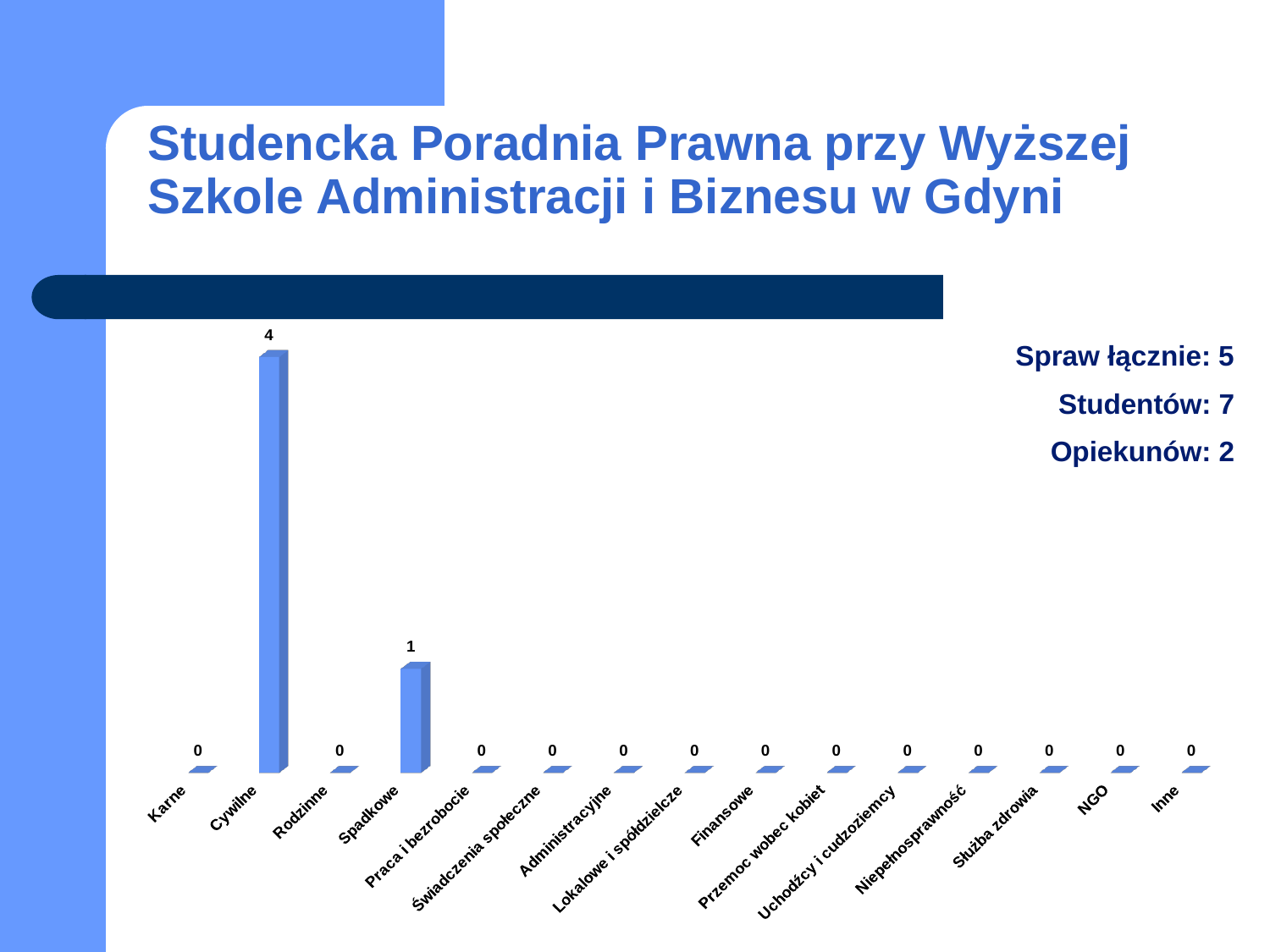
What is the value for Karne? 0 What is the value for Inne? 0 What kind of chart is shown on the slide? bar chart How many categories are shown on the x axis of the chart? 15 What is the value for Spadkowe? 1 How many categories have a value greater than 0? 2 What is the difference between the values for Cywilne and Spadkowe? 3 Which is larger, the value for Spadkowe or the value for Rodzinne? Spadkowe Which category has the highest value? Cywilne What is the value for Finansowe? 0 What is the value for Cywilne? 4 Which is larger, the value for Cywilne or the value for Spadkowe? Cywilne